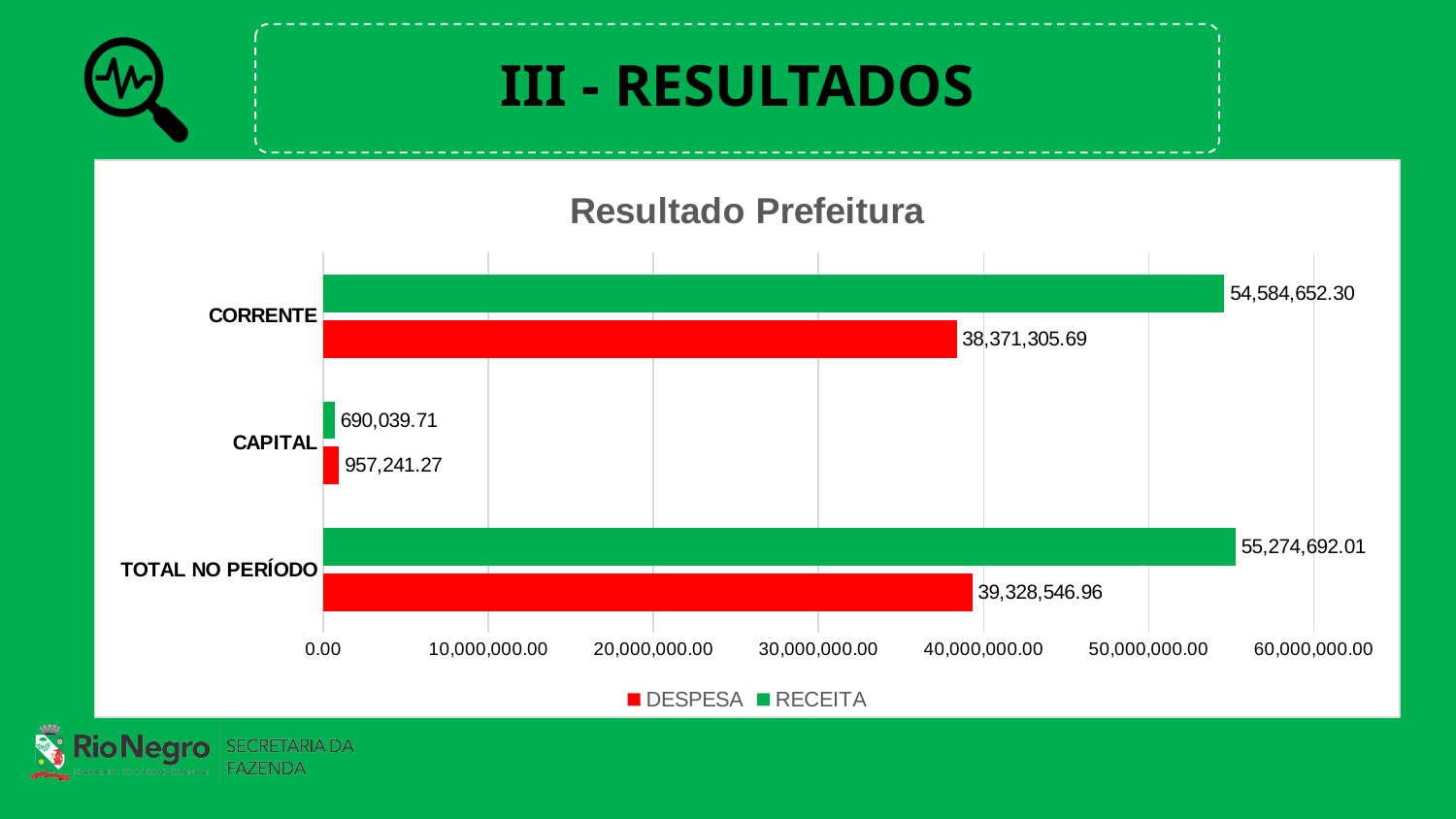
Which category has the lowest RECEITA value? CAPITAL How many series does the legend list? 2 For CAPITAL, which is larger, DESPESA or RECEITA? DESPESA What is the RECEITA value for TOTAL NO PERÍODO? 55,274,692.01 What is the RECEITA value for CORRENTE in the Resultado Prefeitura chart? 54,584,652.30 What is the DESPESA value for CAPITAL in the Resultado Prefeitura chart? 957,241.27 What is the DESPESA value for TOTAL NO PERÍODO? 39,328,546.96 What type of chart is shown on the slide? Bar chart What is the difference between RECEITA and DESPESA for CORRENTE? 16,213,346.61 What is the difference between DESPESA and RECEITA for CAPITAL? 267,201.56 How many categories are shown on the y axis of the chart? 3 Which category has the highest DESPESA value? TOTAL NO PERÍODO